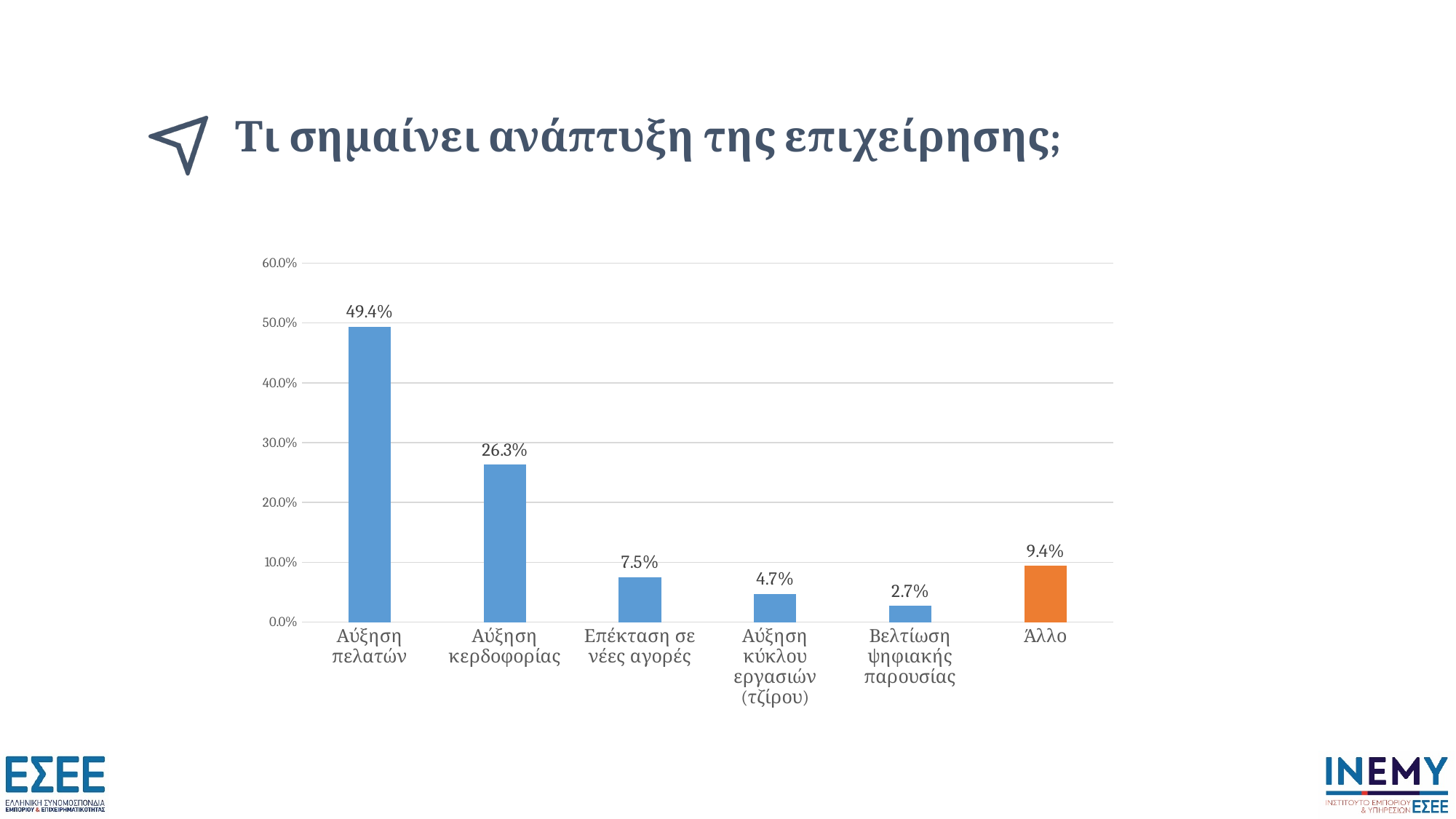
What is the value for Βελτίωση ψηφιακής παρουσίας? 2.7% What is the value for Επέκταση σε νέες αγορές? 7.5% Which is larger, the value for Άλλο or the value for Επέκταση σε νέες αγορές? Άλλο How many categories are shown on the x axis? 6 Which bar is coloured orange rather than blue? Άλλο Which category has the highest value? Αύξηση πελατών Which category has the lowest value? Βελτίωση ψηφιακής παρουσίας What is the difference between the values for Αύξηση πελατών and Αύξηση κερδοφορίας? 23.1% What kind of chart is shown on the slide? bar chart What is the value for Αύξηση πελατών? 49.4% Is the value for Αύξηση κύκλου εργασιών (τζίρου) greater or less than 10.0%? less What is the value for Αύξηση κερδοφορίας? 26.3%